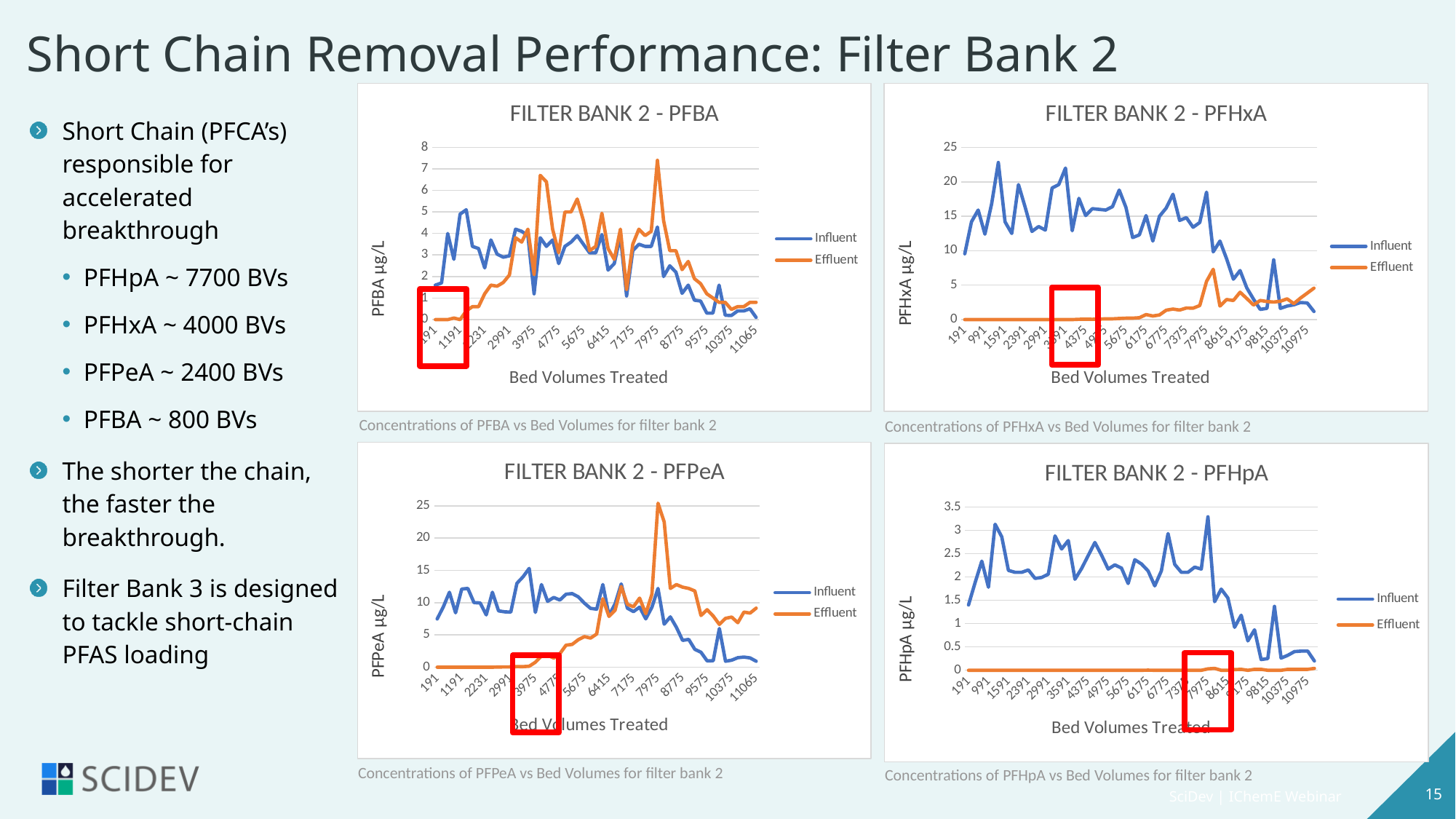
How many charts are shown on the slide? 4 In FILTER BANK 2 - PFPeA, is the peak value of the Effluent series greater or less than 20? greater What are the two legend entries in FILTER BANK 2 - PFPeA? Influent and Effluent In FILTER BANK 2 - PFBA, which series reaches the higher peak, Influent or Effluent? Effluent In FILTER BANK 2 - PFHpA, is the Effluent series greater or less than 0.5 across the whole x axis? less In FILTER BANK 2 - PFHpA, does the Influent series overall rise or fall toward the right end of the x axis? fall What is the y-axis title of FILTER BANK 2 - PFHxA? PFHxA µg/L In FILTER BANK 2 - PFPeA, is the highest Influent value greater or less than 10? greater How many series does the legend of FILTER BANK 2 - PFHxA list? 2 What kind of chart is FILTER BANK 2 - PFBA? line chart In FILTER BANK 2 - PFHxA, does the Influent series overall rise or fall from left to right along the x axis? fall